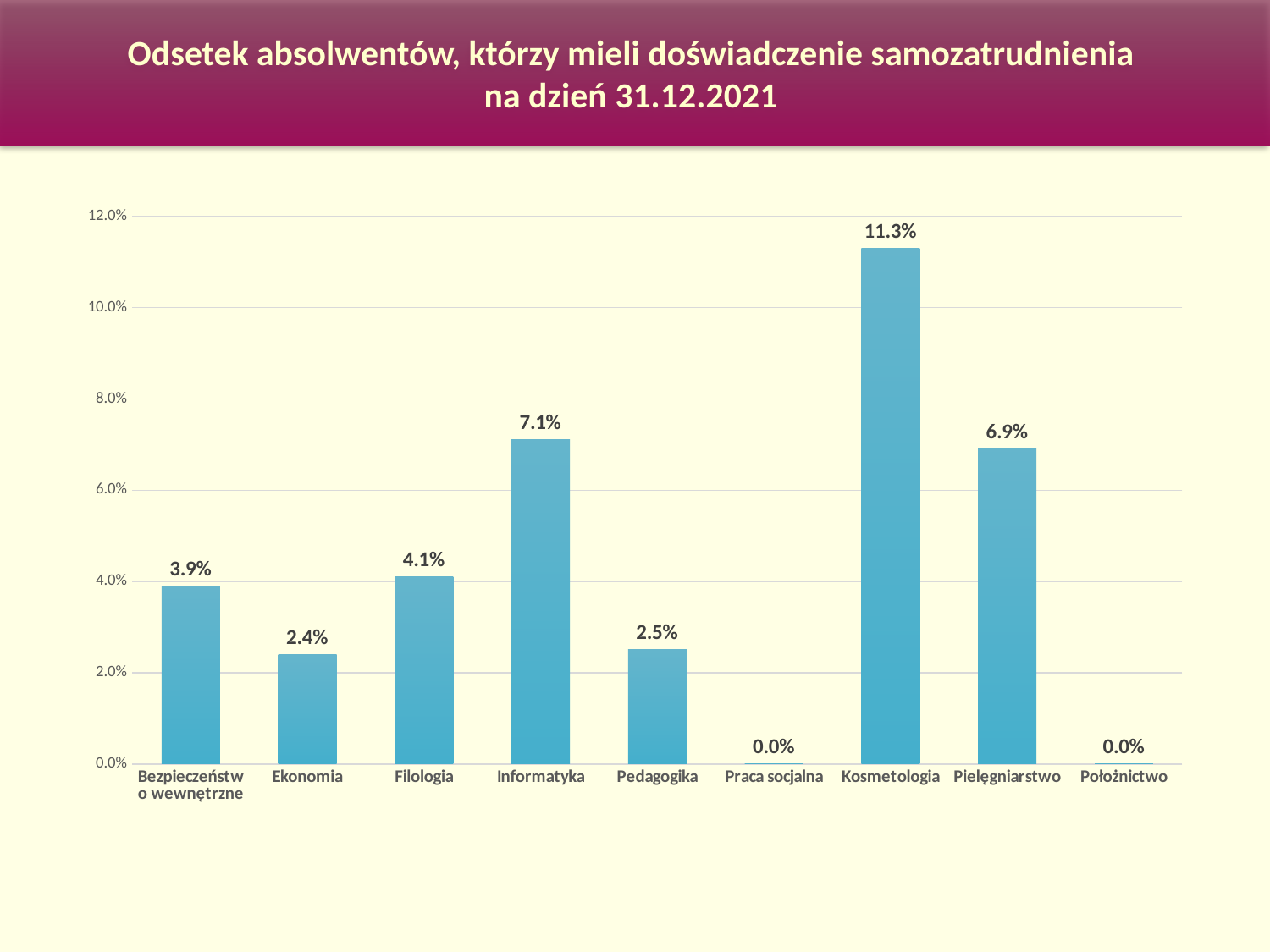
What is the title of the chart? Odsetek absolwentów, którzy mieli doświadczenie samozatrudnienia na dzień 31.12.2021 What is the value for Ekonomia? 2.4% What is the value for Informatyka? 7.1% What is the value for Kosmetologia? 11.3% What is the difference between the values for Kosmetologia and Pielęgniarstwo? 4.4% How many categories have a value of 0.0%? 2 How many categories are shown on the x axis? 9 What is the difference between the values for Informatyka and Pedagogika? 4.6% Is the value for Pielęgniarstwo greater or less than 6.0%? greater Which category has the highest value? Kosmetologia Which is larger, the value for Filologia or the value for Bezpieczeństwo wewnętrzne? Filologia What kind of chart is shown on the slide? bar chart